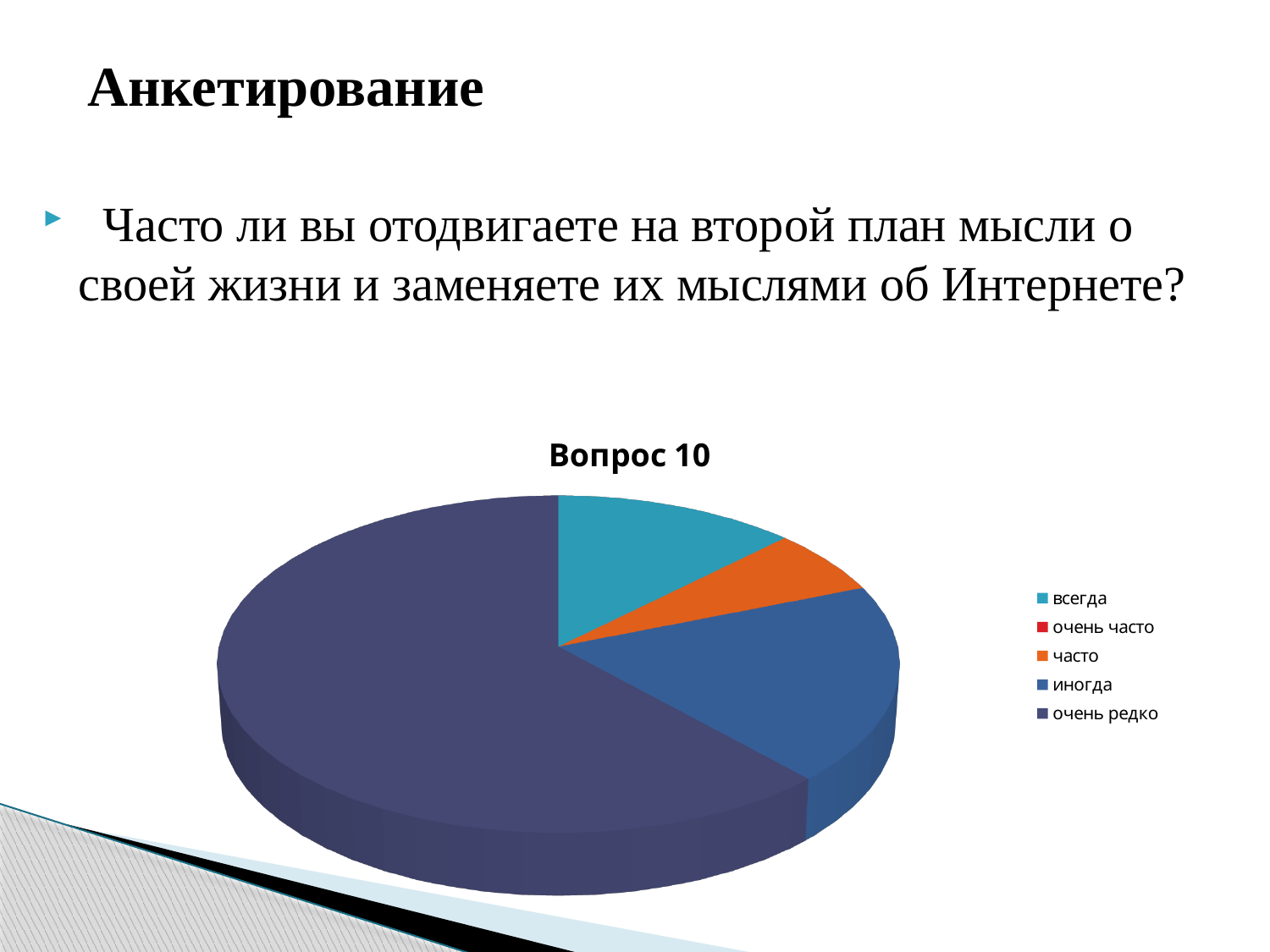
Which slice is larger, иногда or часто? иногда Which slice is larger, очень редко or иногда? очень редко Which legend entry is shown in orange? часто Which category has the largest slice of the pie? очень редко Which slice is larger, иногда or всегда? иногда What kind of chart is shown on the slide? pie chart Does the slice for очень редко take up more or less than half of the pie? more What is the title of the chart? Вопрос 10 How many entries does the chart's legend list? 5